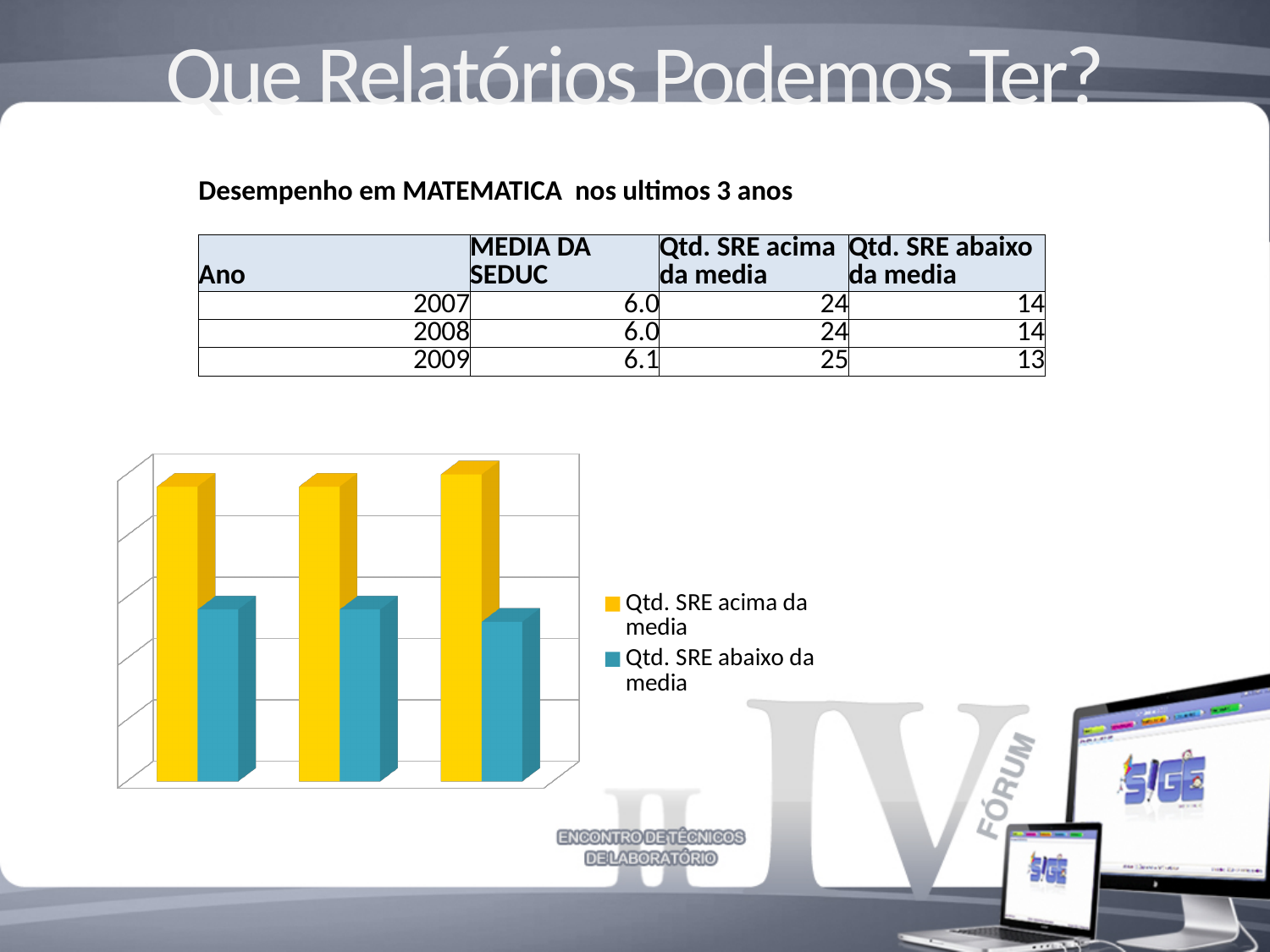
What kind of chart is shown on the slide? bar chart Which series is shown in blue in the chart? Qtd. SRE abaixo da media How many series does the chart's legend list? 2 In the leftmost group of bars, which series has the taller bar, Qtd. SRE acima da media or Qtd. SRE abaixo da media? Qtd. SRE acima da media In the rightmost group of bars, is the Qtd. SRE abaixo da media bar taller or shorter than the Qtd. SRE acima da media bar? shorter Which group of bars, from left to right, has the tallest Qtd. SRE acima da media bar? the third (rightmost) group How many groups of bars are plotted in the chart? 3 Which series is shown in yellow in the chart? Qtd. SRE acima da media Which group of bars, from left to right, has the shortest Qtd. SRE abaixo da media bar? the third (rightmost) group Across the three groups from left to right, does the Qtd. SRE abaixo da media bar end higher or lower in the last group than in the first? lower